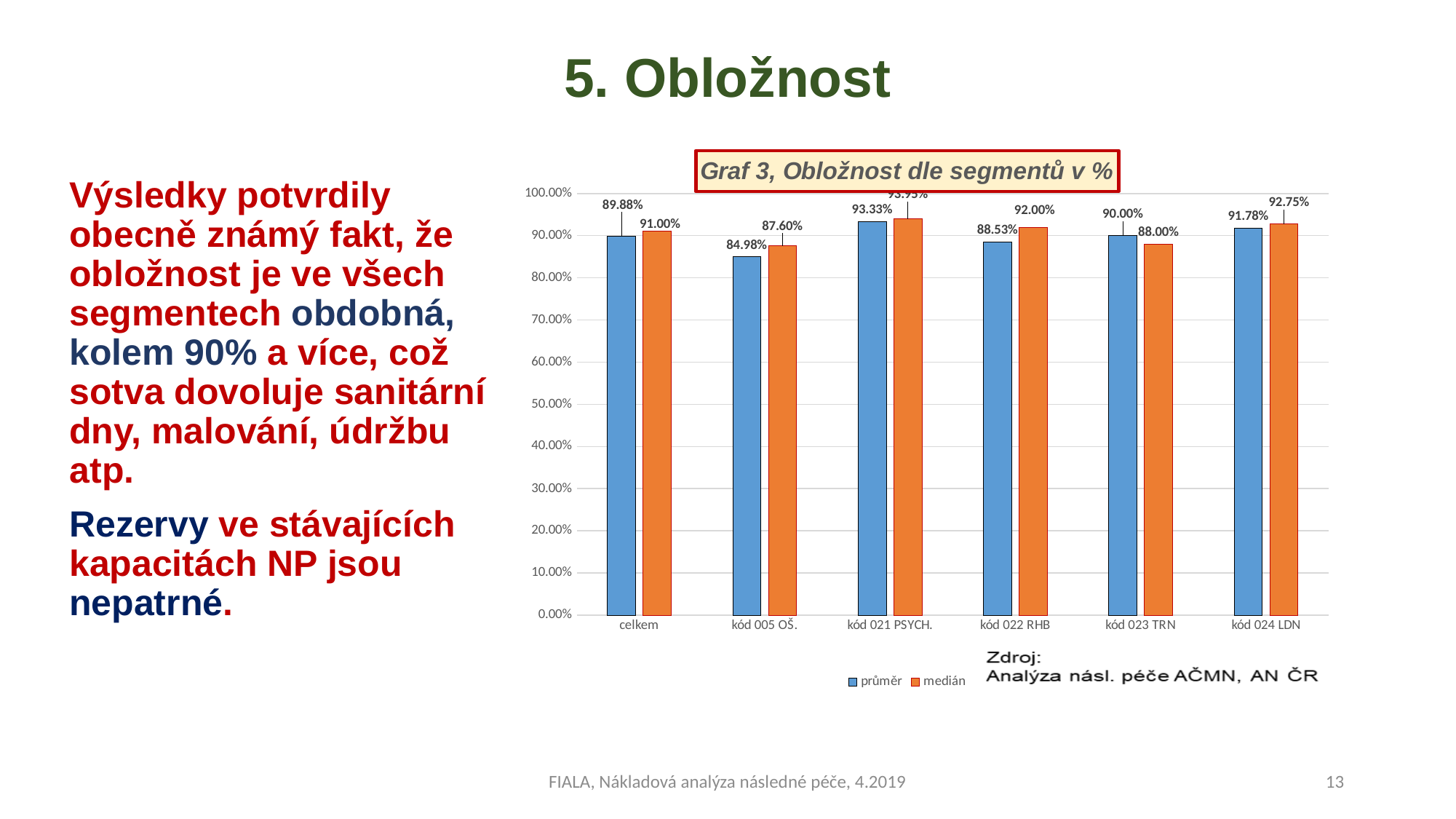
What kind of chart is shown on the slide? bar chart What is the medián value for kód 022 RHB? 92.00% What is the difference between the medián and průměr values for kód 022 RHB? 3.47% How many series does the legend list? 2 Which category has the lowest medián value? kód 005 OŠ. What is the průměr value for kód 005 OŠ.? 84.98% For kód 023 TRN, which is larger: průměr or medián? průměr How many categories are shown on the x axis? 6 What is the difference between the medián and průměr values for kód 023 TRN? 2.00% What is the medián value for celkem? 91.00% What is the průměr value for kód 024 LDN? 91.78% Which category has the highest průměr value? kód 021 PSYCH.